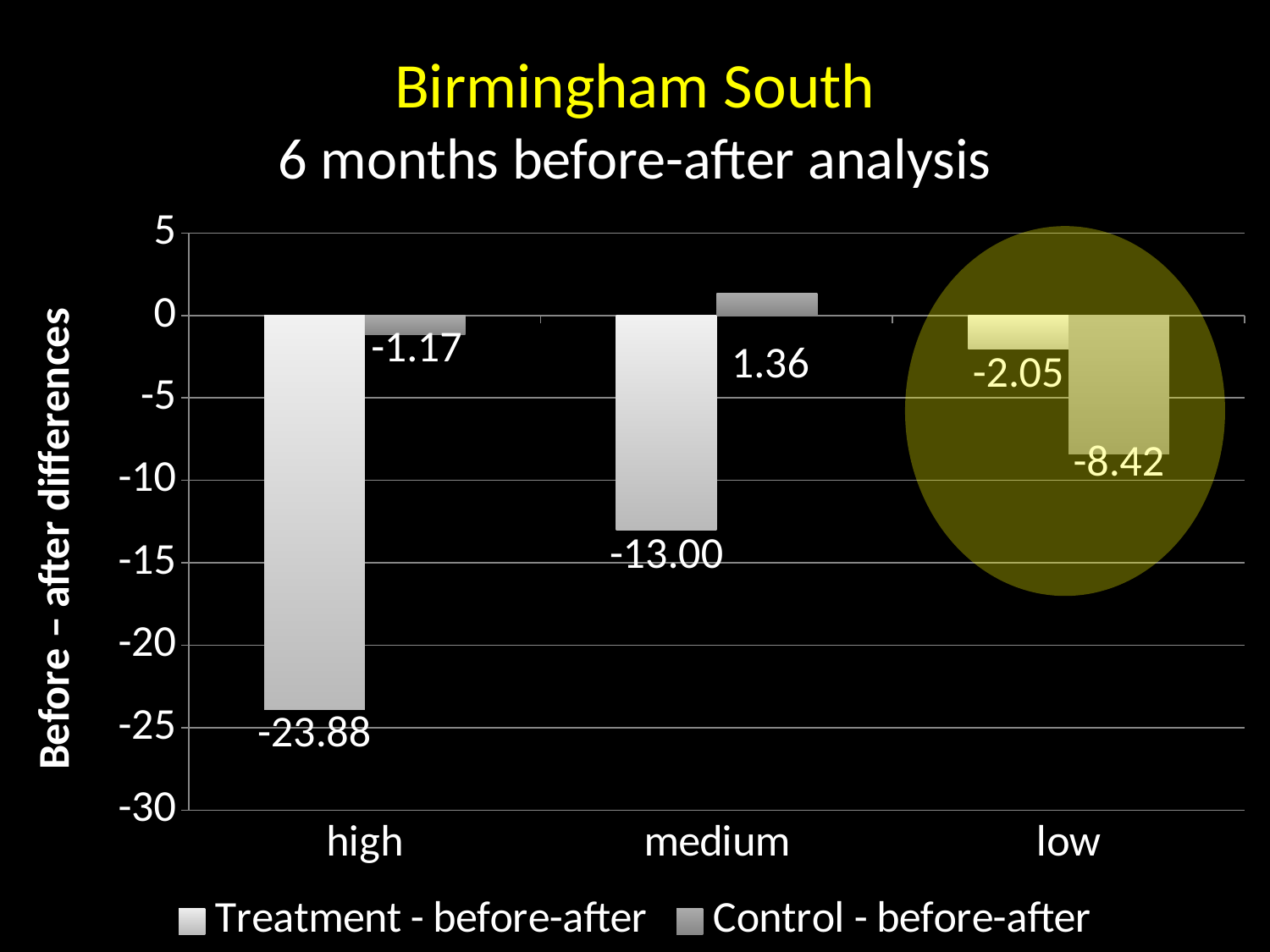
What is the Treatment - before-after value for the high category? -23.88 What is the difference between the Treatment - before-after values for high and medium? 10.88 What is the label of the y axis? Before – after differences Which category has the highest Control - before-after value? medium What is the Control - before-after value for the low category? -8.42 How many series does the legend list? 2 What is the Treatment - before-after value for the low category? -2.05 What kind of chart is shown on the slide? bar chart Which is larger for the low category, the Treatment - before-after value or the Control - before-after value? Treatment - before-after Which category has the lowest Treatment - before-after value? high How many categories are shown on the x axis? 3 What is the Control - before-after value for the medium category? 1.36